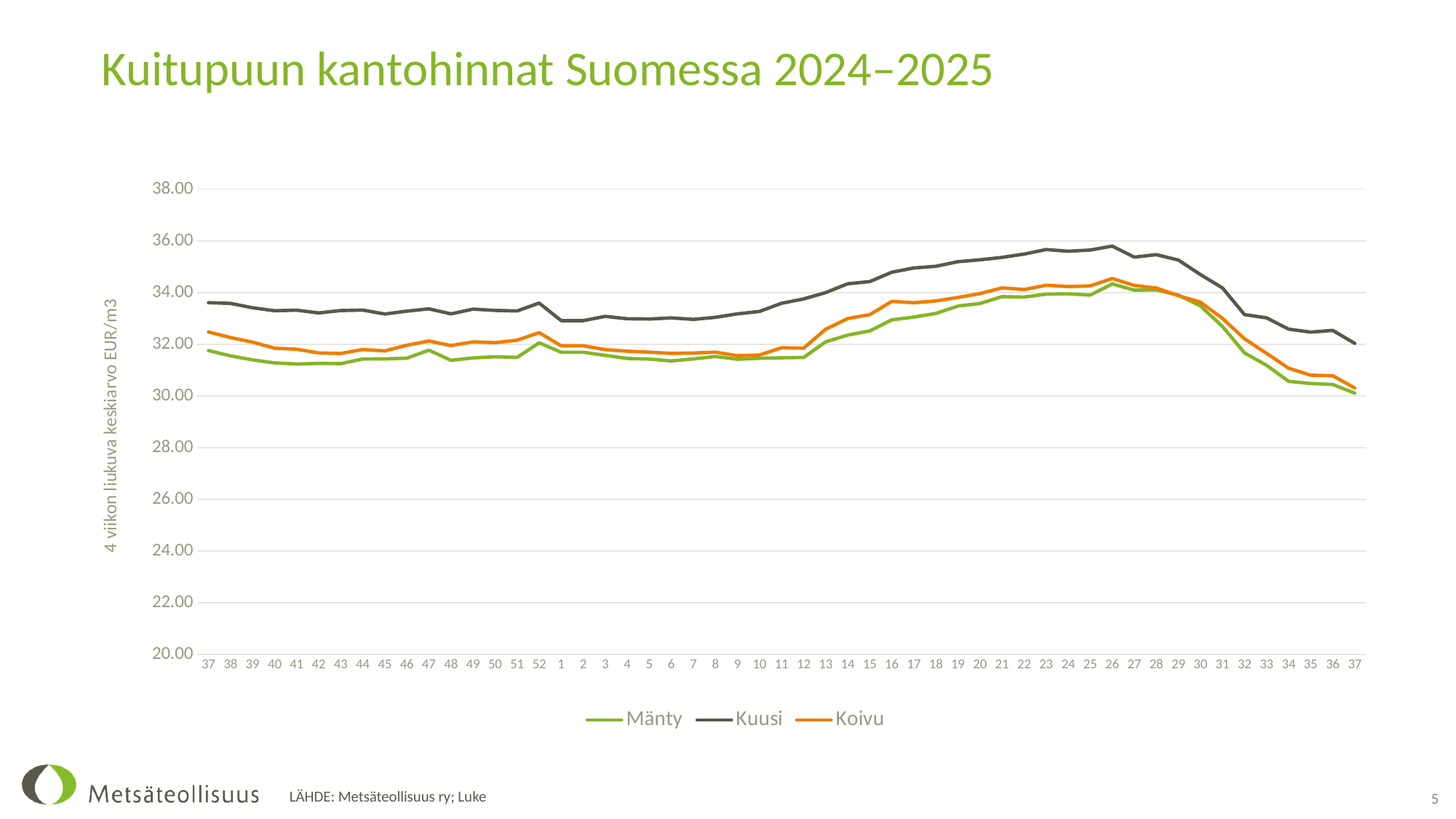
How many series does the legend list? 3 Do the Mänty values rise or fall from week 30 to the last week 37 on the right? fall What kind of chart is shown on the slide? line chart Is the value for Mänty at week 40 greater or less than 32.00? less What is the label of the vertical axis? 4 viikon liukuva keskiarvo EUR/m3 Is the value for Koivu at the last week 37 on the right end of the chart greater or less than 32.00? less What is the title of the chart? Kuitupuun kantohinnat Suomessa 2024–2025 Which series has the highest values across the whole chart? Kuusi How many week points are plotted along the x axis? 53 At week 20, which is higher, Kuusi or Mänty? Kuusi Which series has the lowest value at the last week 37 on the right end of the chart? Mänty Is the value for Kuusi at week 26 greater or less than 34.00? greater